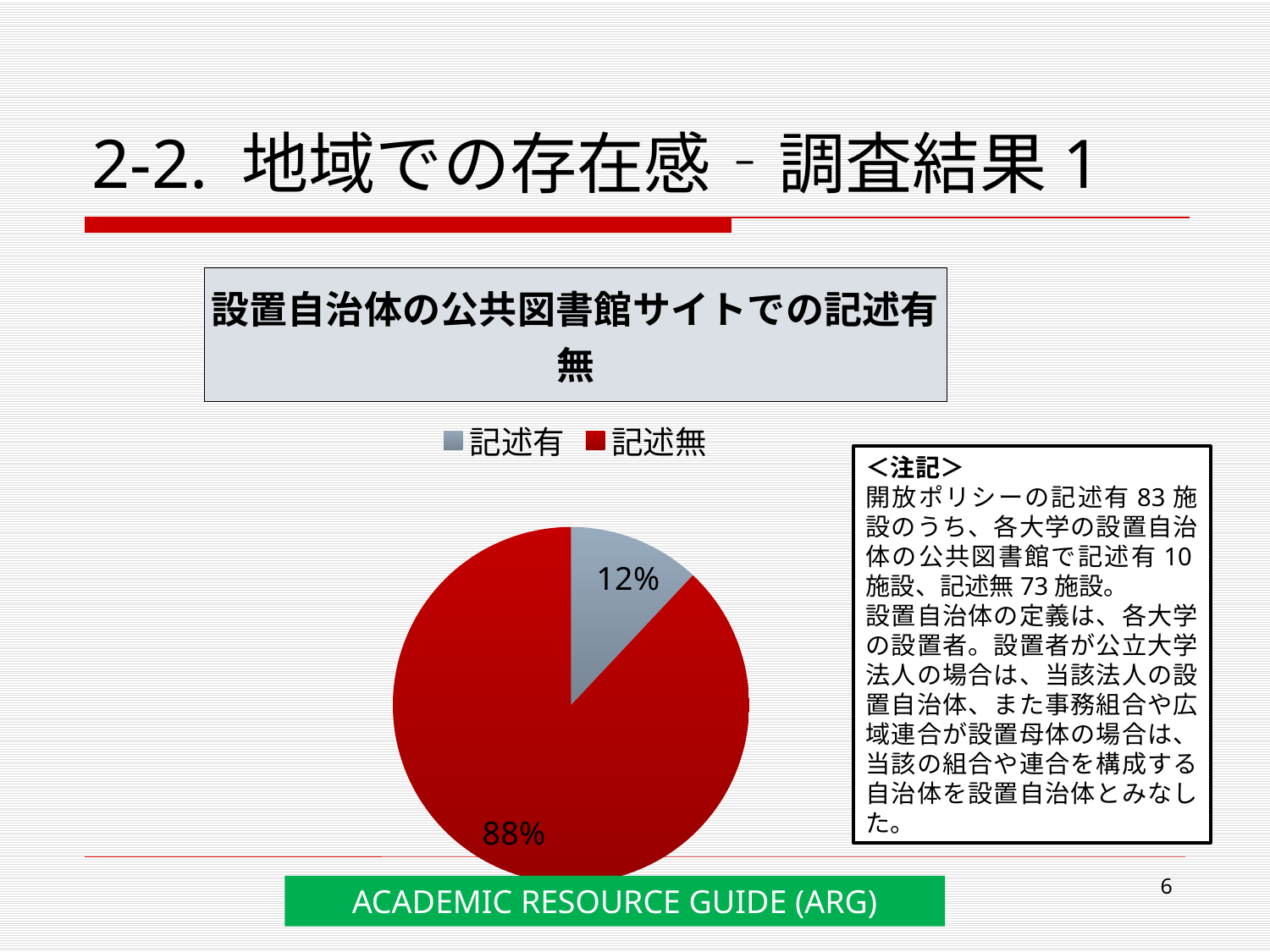
What colour is the 記述無 slice? red Is the share for 記述有 greater or less than 50%? less Which slice is larger, 記述有 or 記述無? 記述無 What share of the pie does 記述無 represent? 88% Which category has the smallest slice of the pie? 記述有 How many entries does the legend list? 2 What is the difference in percentage points between the 記述無 and 記述有 slices? 76 What share of the pie does 記述有 represent? 12% What kind of chart is shown on the slide? pie chart How many slices does the pie chart have? 2 What is the title of the chart? 設置自治体の公共図書館サイトでの記述有無 Which category has the largest slice of the pie? 記述無